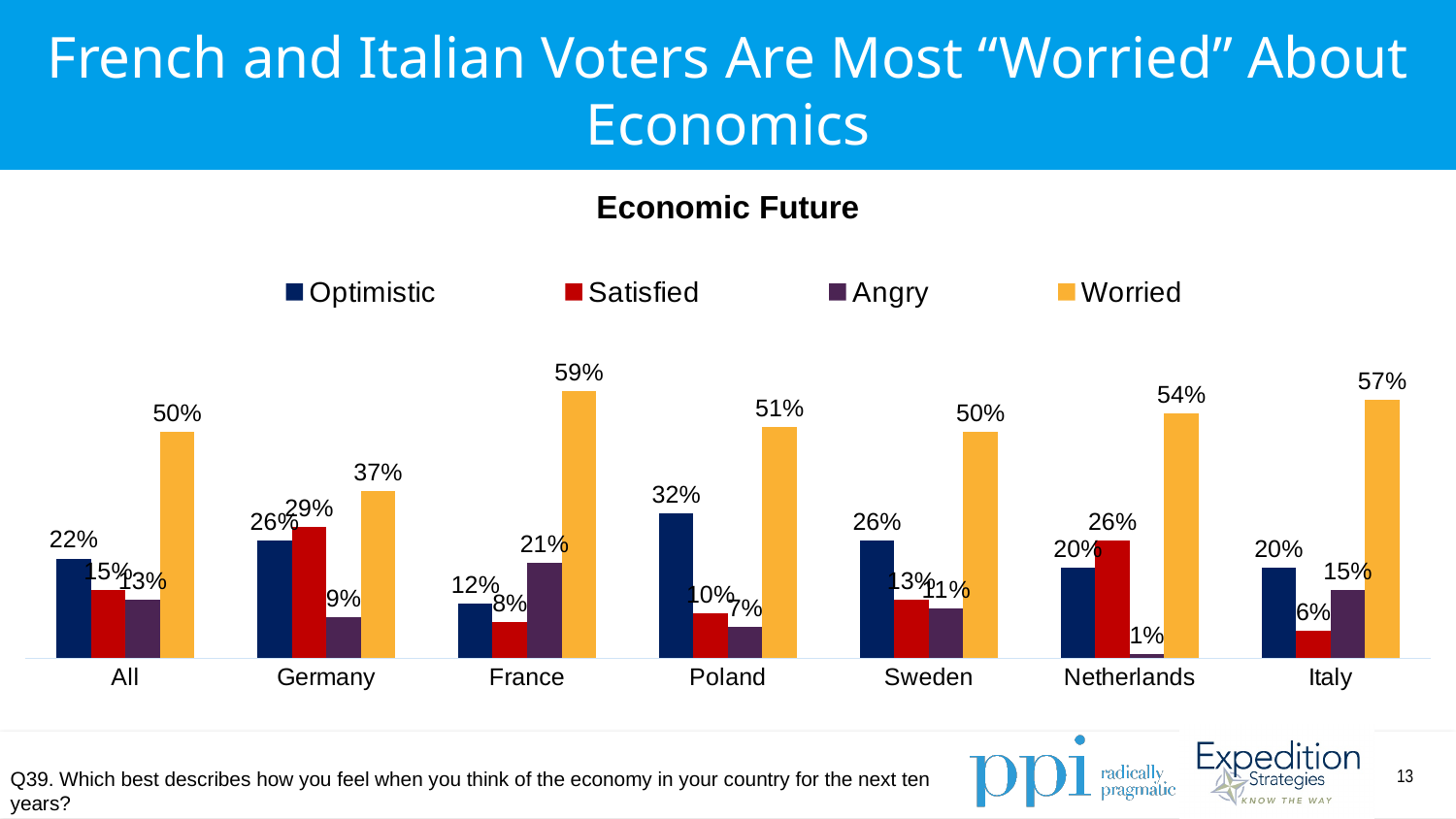
What is the Angry value for the Netherlands? 1% Which is larger, the Optimistic value for Poland or the Optimistic value for Sweden? Poland What is the difference between the Worried values for Italy and Germany? 20% What percentage of French voters are Worried about the economic future? 59% Which country has the highest Worried value? France How many series does the legend list? 4 Which country has the lowest Worried value? Germany What is the title of the chart? Economic Future How many countries or groups are shown on the x axis? 7 What kind of chart is shown on the slide? Bar chart What is the Optimistic value for Poland? 32% What is the Satisfied value for Germany? 29%